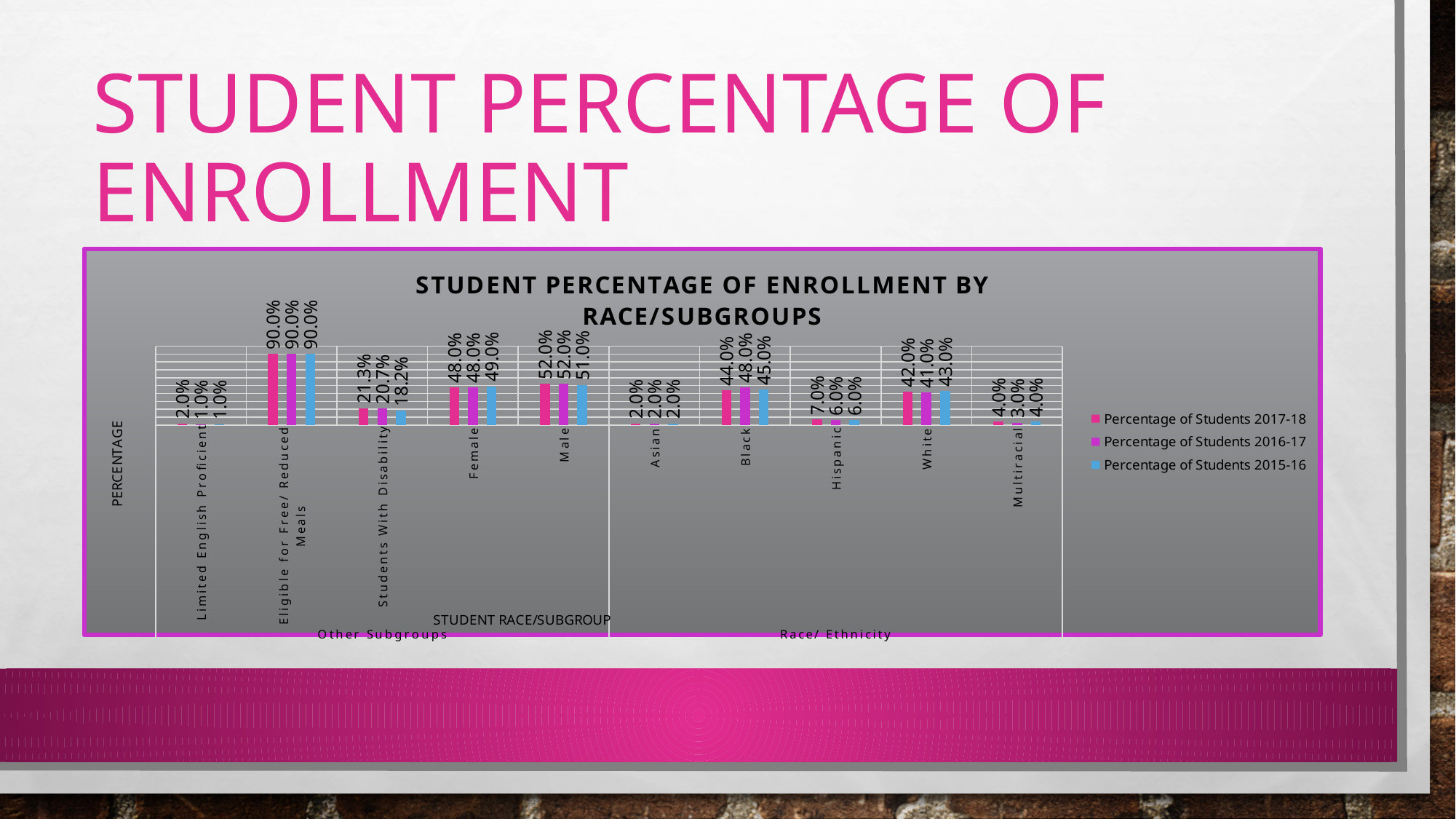
How many categories are shown on the x axis? 10 What is the difference between the Students With Disability values for 2017-18 and 2015-16? 3.1% What is the difference between the Male and Female values in the Percentage of Students 2015-16 series? 2.0% How many series does the legend list? 3 Which is larger in the Percentage of Students 2015-16 series: Black or White? Black Which category has the lowest value in the Percentage of Students 2016-17 series? Limited English Proficient What is the value for Black in the Percentage of Students 2016-17 series? 48.0% What is the value for Students With Disability in the Percentage of Students 2017-18 series? 21.3% What is the title of the chart? Student Percentage of Enrollment by Race/Subgroups What is the value for White in the Percentage of Students 2015-16 series? 43.0% What type of chart is shown on the slide? Bar chart Which category has the highest value in the Percentage of Students 2017-18 series? Eligible for Free/ Reduced Meals